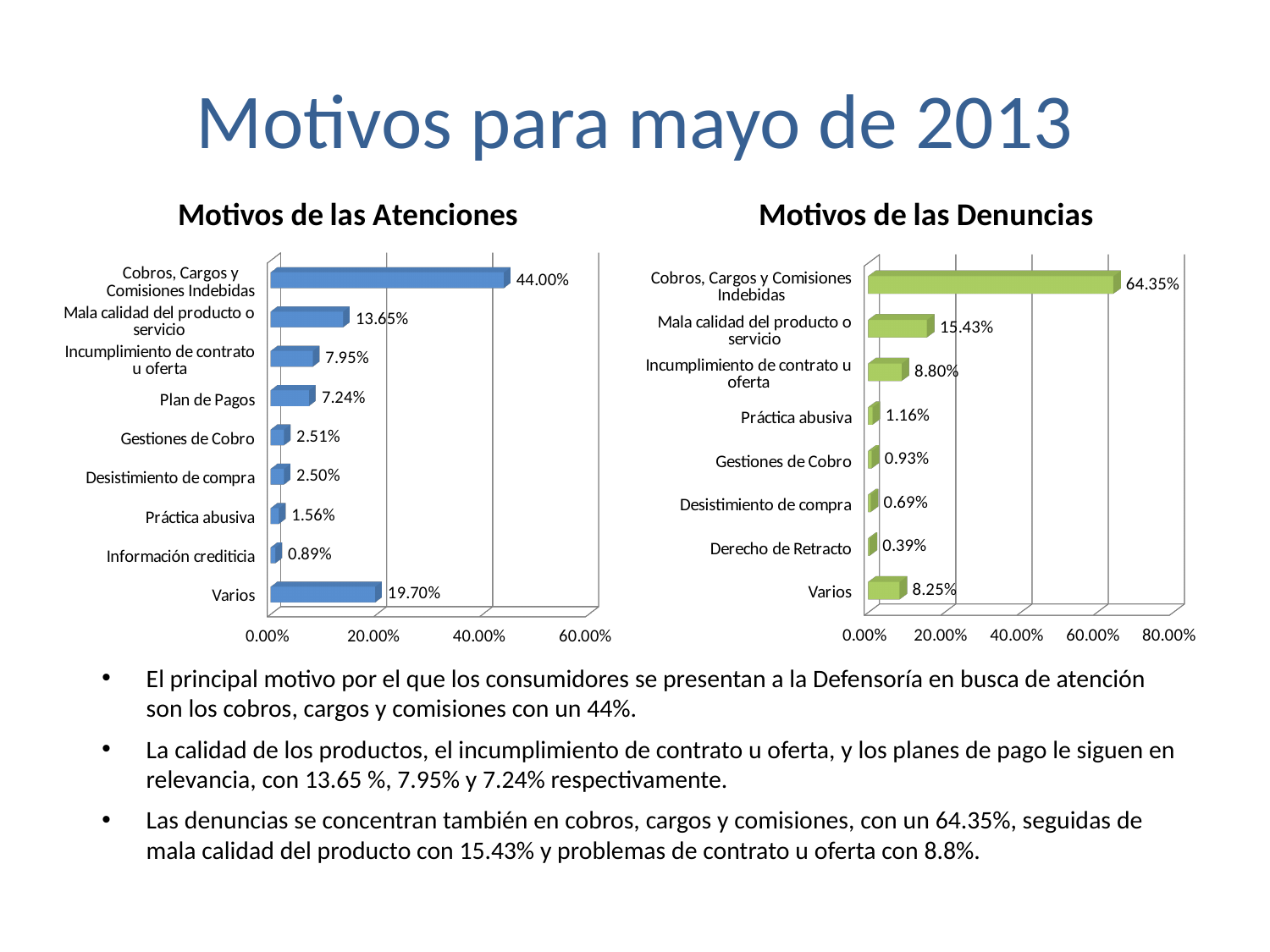
What kind of chart is 'Motivos de las Denuncias'? Bar chart What colour are the bars in the 'Motivos de las Atenciones' chart? Blue In the 'Motivos de las Denuncias' chart, which category has the highest value? Cobros, Cargos y Comisiones Indebidas In the 'Motivos de las Atenciones' chart, which category has the lowest value? Información crediticia In the 'Motivos de las Atenciones' chart, what is the value for Varios? 19.70% In the 'Motivos de las Denuncias' chart, which is larger: Incumplimiento de contrato u oferta or Varios? Incumplimiento de contrato u oferta In the 'Motivos de las Denuncias' chart, which category has the lowest value? Derecho de Retracto How many categories are shown in the 'Motivos de las Atenciones' chart? 9 In the 'Motivos de las Atenciones' chart, what is the value for Cobros, Cargos y Comisiones Indebidas? 44.00% In the 'Motivos de las Denuncias' chart, what is the value for Mala calidad del producto o servicio? 15.43% In the 'Motivos de las Atenciones' chart, what is the difference between Mala calidad del producto o servicio and Incumplimiento de contrato u oferta? 5.70% How many categories are shown in the 'Motivos de las Denuncias' chart? 8